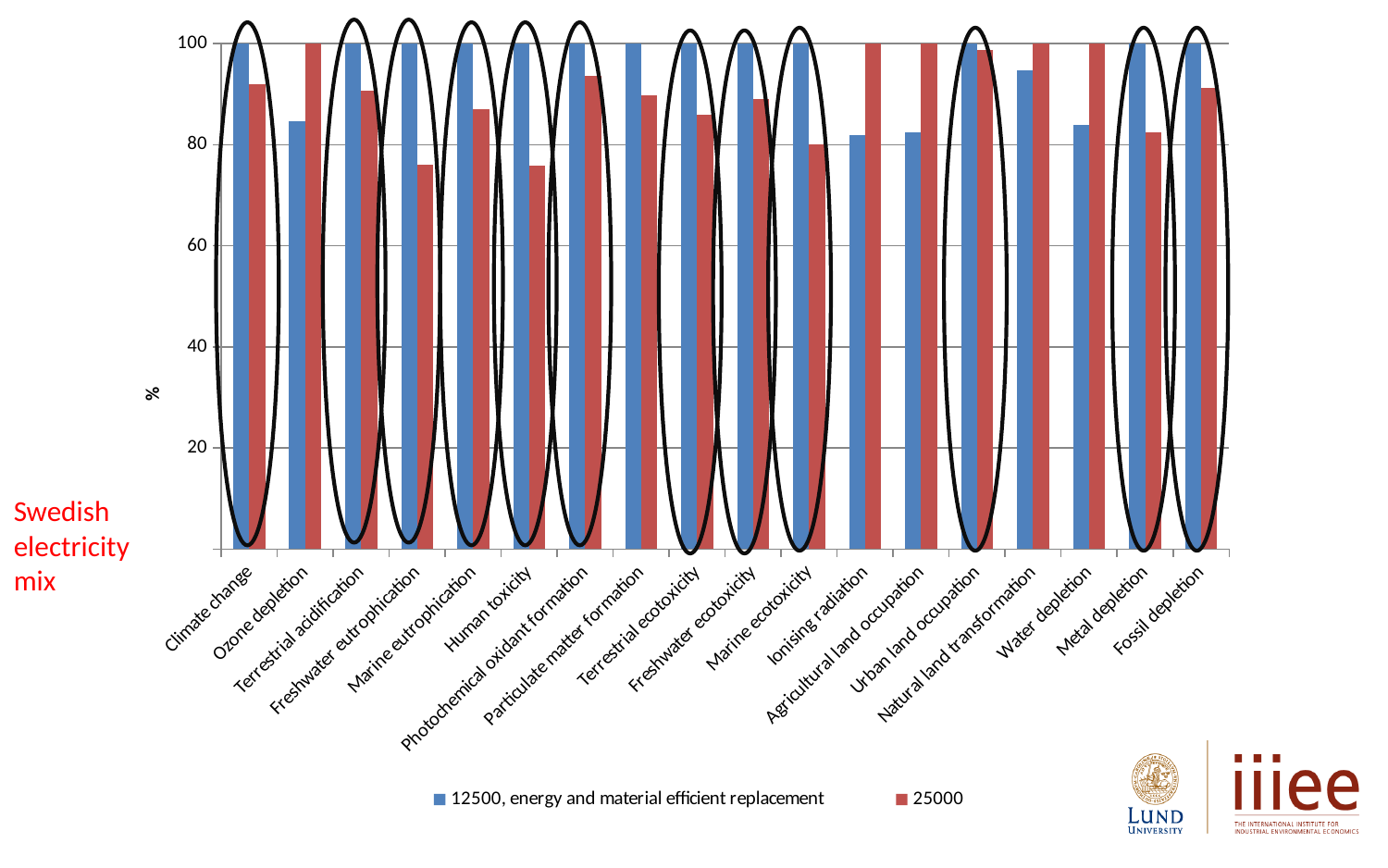
Is the value for Human toxicity in the '25000' series greater or less than 80? less For Climate change, which series has the larger value: '12500, energy and material efficient replacement' or '25000'? 12500, energy and material efficient replacement How many impact categories are shown along the x axis? 18 What is the label on the y axis? % Is the value for Freshwater eutrophication in the '25000' series greater or less than 80? less What is the value for Climate change in the '12500, energy and material efficient replacement' series? 100 Is the value for Ozone depletion in the '12500, energy and material efficient replacement' series greater or less than 80? greater What is the value for Ozone depletion in the '25000' series? 100 What is the value for Water depletion in the '25000' series? 100 For Ionising radiation, which series has the larger value: '12500, energy and material efficient replacement' or '25000'? 25000 What kind of chart is shown on the slide? bar chart How many series does the legend list? 2